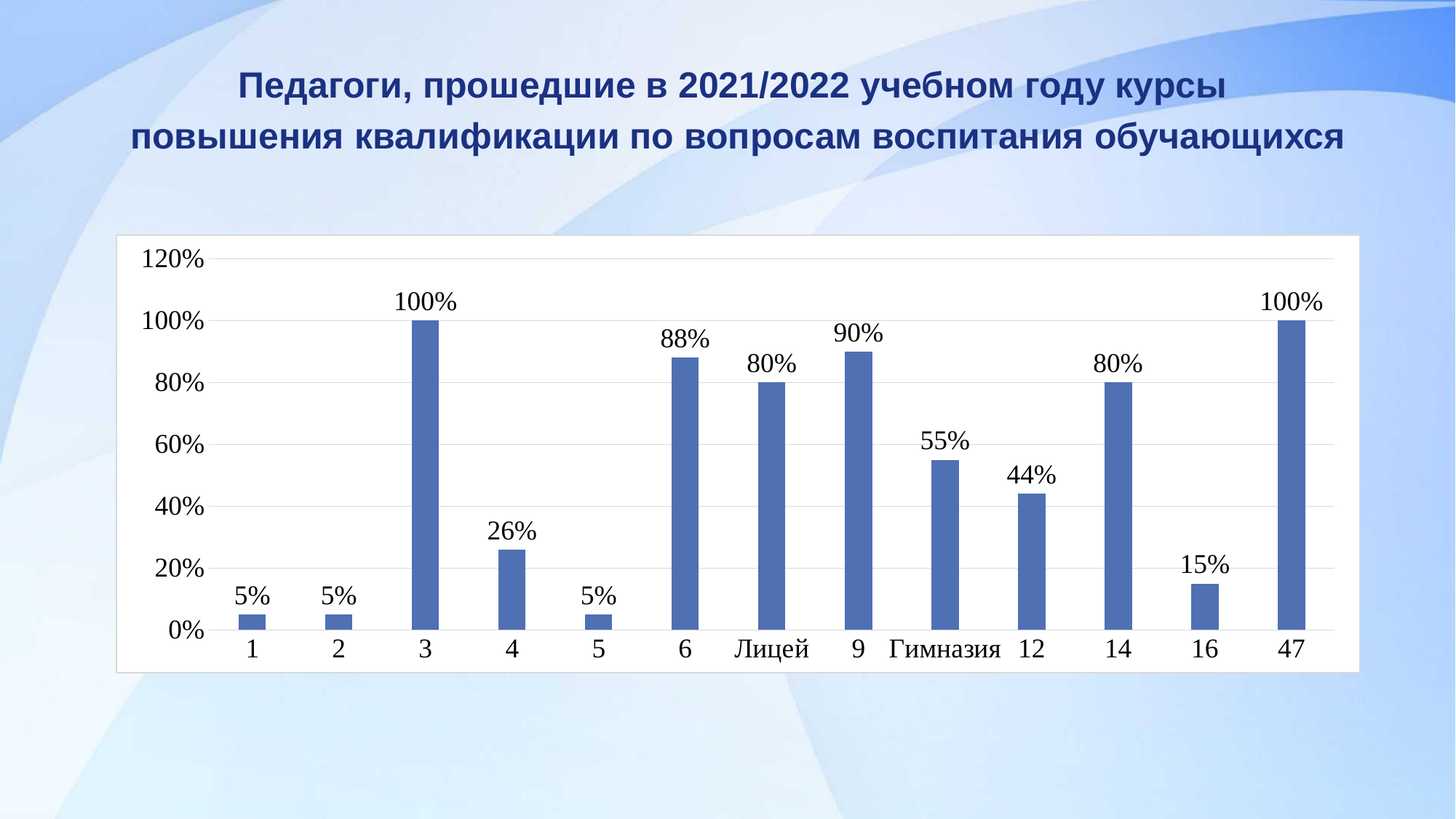
Which has a larger value, category 4 or category 16? 4 What is the value for category 3? 100% What is the difference between the values for category 9 and Гимназия? 35% What is the value for Гимназия? 55% What is the value for category 16? 15% What is the difference between the values for category 6 and category 12? 44% What is the value for category 9? 90% How many categories are shown on the x axis? 13 What is the value for Лицей? 80% What kind of chart is shown on the slide? Bar chart What is the highest value shown in the chart? 100% What is the lowest value shown in the chart? 5%